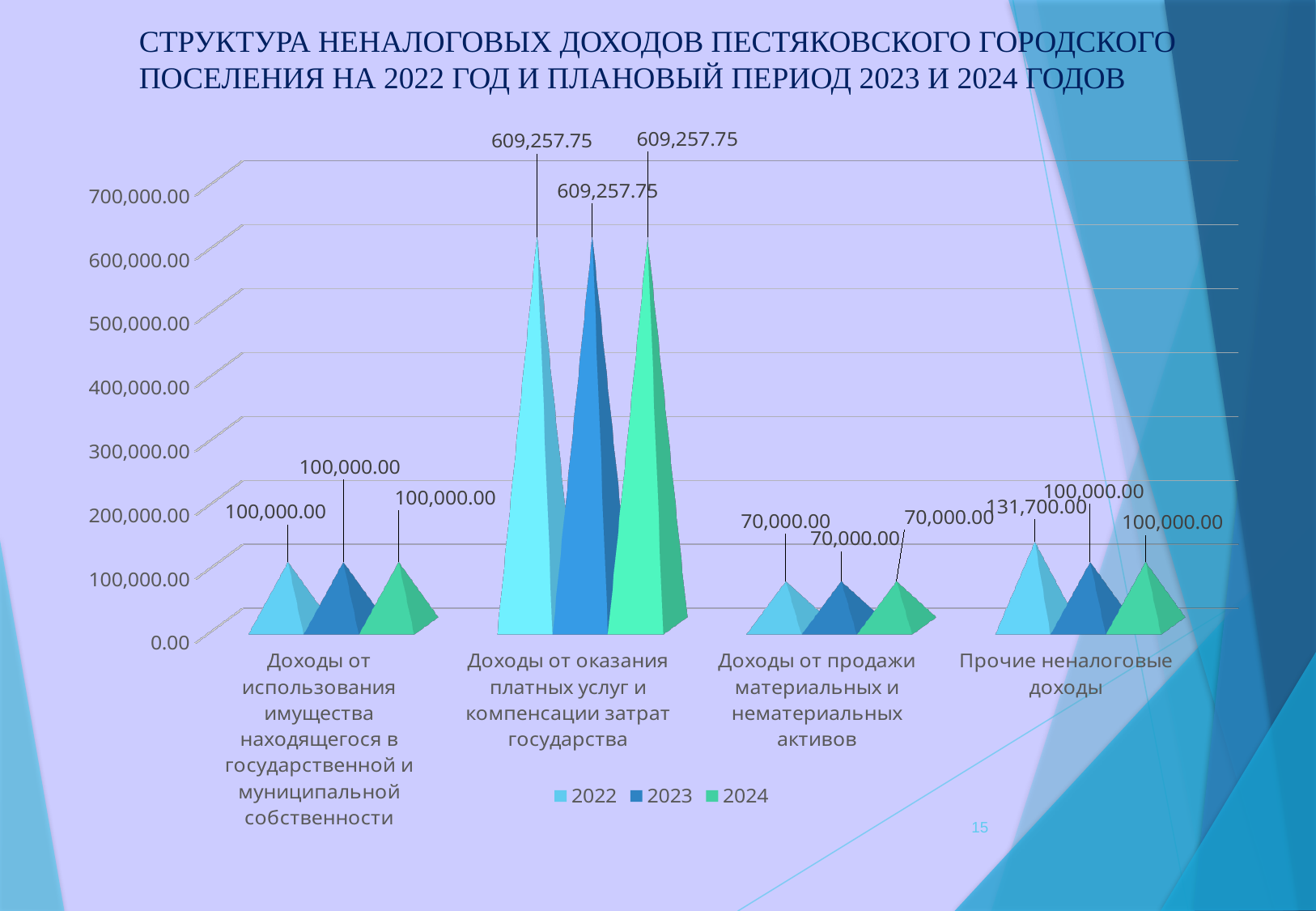
What is the value for 2023 in the category "Доходы от использования имущества находящегося в государственной и муниципальной собственности"? 100,000.00 What is the difference between the 2022 value for "Доходы от оказания платных услуг и компенсации затрат государства" and the 2022 value for "Доходы от использования имущества находящегося в государственной и муниципальной собственности"? 509,257.75 What is the value for 2022 in the category "Прочие неналоговые доходы"? 131,700.00 How many series does the chart legend list? 3 What is the value for 2022 in the category "Доходы от оказания платных услуг и компенсации затрат государства"? 609,257.75 Which category has the lowest value for 2024? Доходы от продажи материальных и нематериальных активов What is the value for 2024 in the category "Доходы от продажи материальных и нематериальных активов"? 70,000.00 Which series are listed in the chart legend? 2022, 2023, 2024 What is the difference between the 2022 value and the 2023 value for "Прочие неналоговые доходы"? 31,700.00 How many categories are shown on the x axis of the chart? 4 Which is larger: the 2022 value for "Прочие неналоговые доходы" or the 2022 value for "Доходы от продажи материальных и нематериальных активов"? Прочие неналоговые доходы Which category has the highest value for 2023? Доходы от оказания платных услуг и компенсации затрат государства